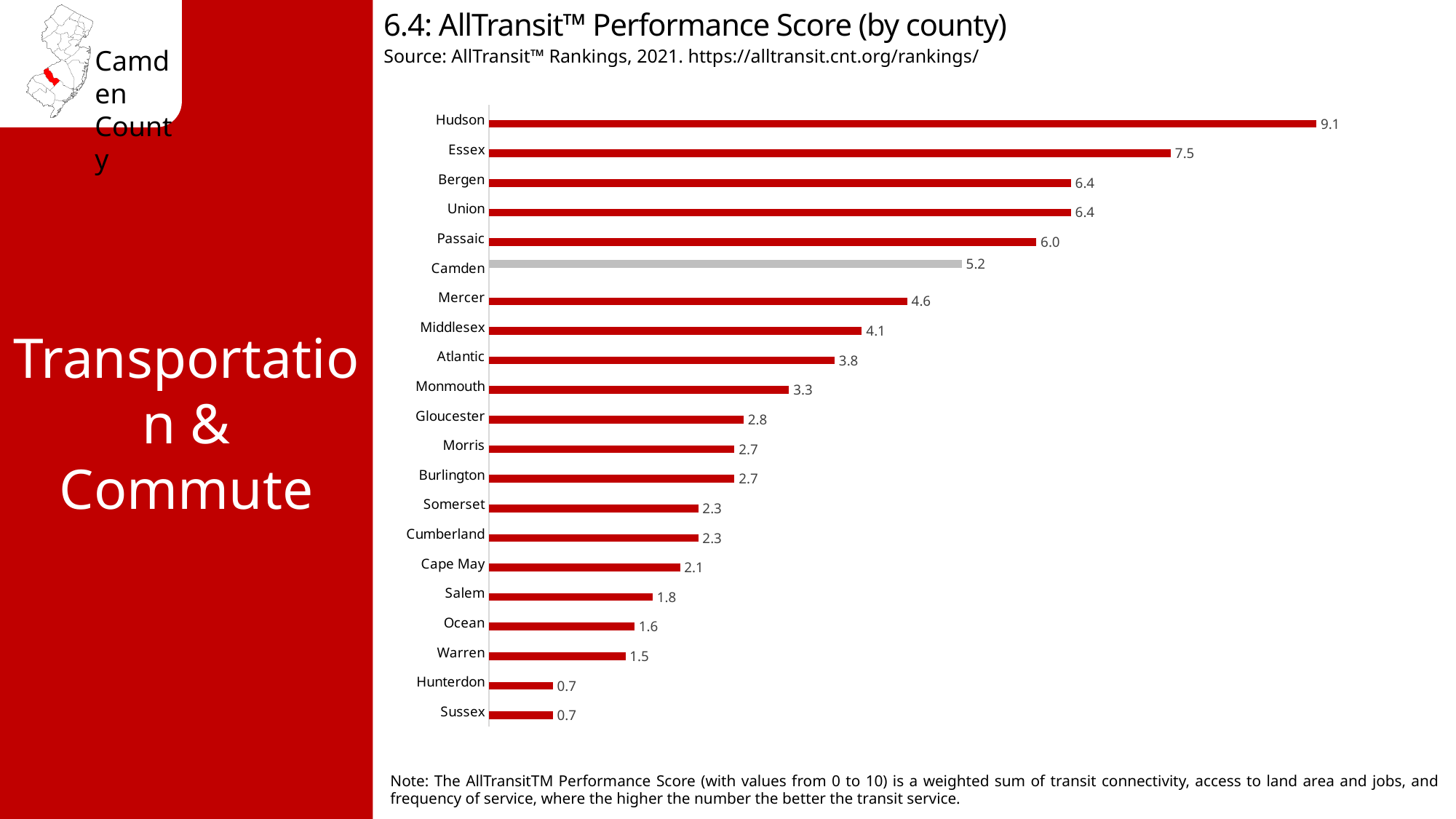
Which county has the highest AllTransit Performance Score? Hudson What is the difference between the scores for Camden and Burlington? 2.5 How many counties are shown in the chart? 21 What is the AllTransit Performance Score for Camden? 5.2 What is the AllTransit Performance Score for Mercer? 4.6 Which has a higher score, Atlantic or Monmouth? Atlantic Which has a higher score, Passaic or Middlesex? Passaic What is the AllTransit Performance Score for Gloucester? 2.8 Which county's bar is coloured grey instead of red? Camden What is the title of the chart? 6.4: AllTransit™ Performance Score (by county) What kind of chart is shown on the slide? Bar chart What is the difference between the scores for Hudson and Essex? 1.6